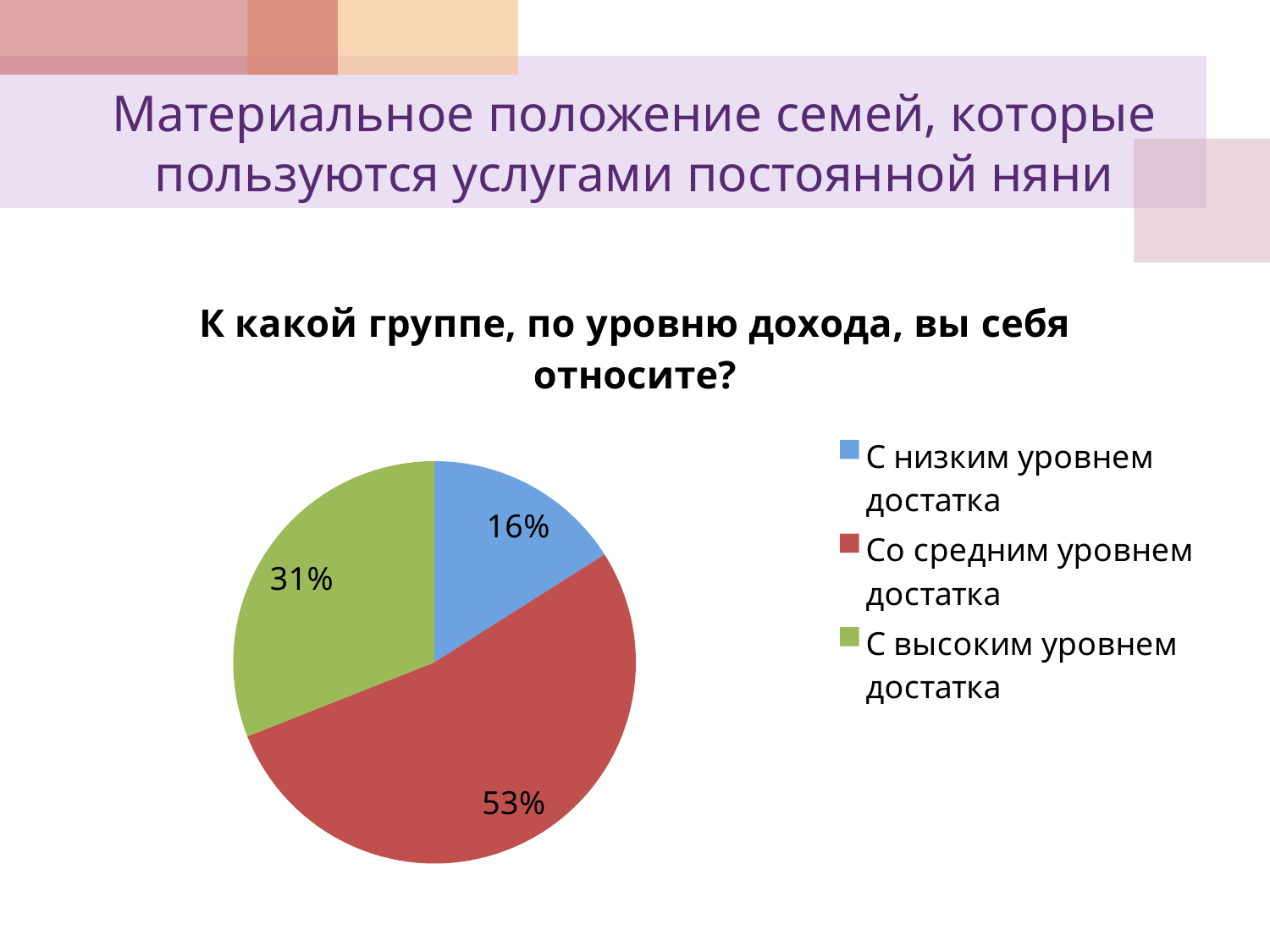
Which income group has the smallest slice of the pie? С низким уровнем достатка What is the difference in percentage points between the 'Со средним уровнем достатка' slice and the 'С высоким уровнем достатка' slice? 22 What colour is the slice for 'Со средним уровнем достатка'? Red How many entries does the legend list? 3 What share of the pie is labelled for 'С низким уровнем достатка'? 16% What is the difference in percentage points between the 'С высоким уровнем достатка' slice and the 'С низким уровнем достатка' slice? 15 What share of the pie is labelled for 'С высоким уровнем достатка'? 31% Which slice is larger: 'С высоким уровнем достатка' or 'С низким уровнем достатка'? С высоким уровнем достатка How many slices does the pie chart have? 3 What share of the pie is labelled for 'Со средним уровнем достатка'? 53% Which income group has the largest slice of the pie? Со средним уровнем достатка What kind of chart is shown on the slide? Pie chart